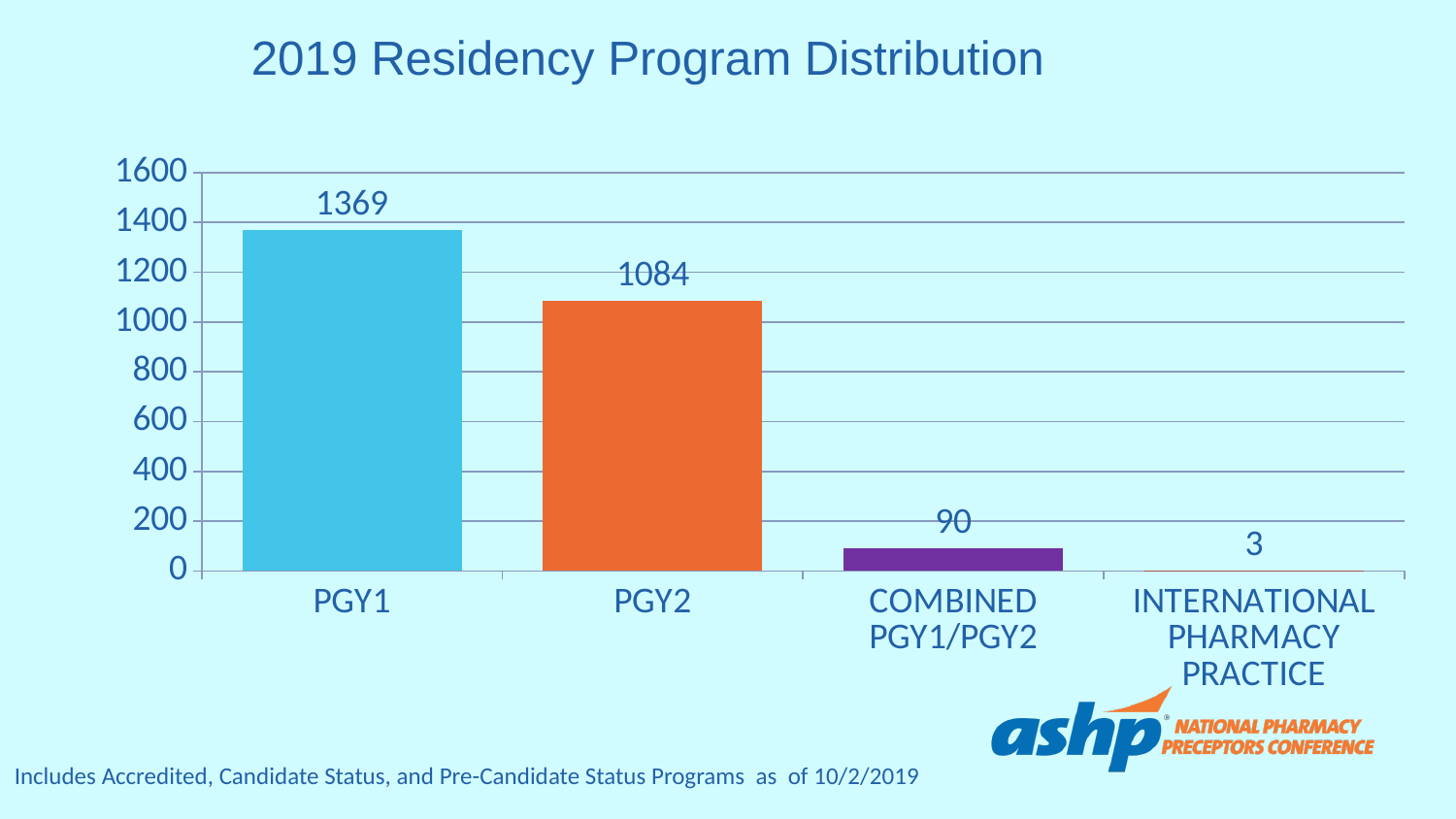
Is the value for PGY2 greater or less than 1000? greater What kind of chart is shown on the slide? bar chart What is the title of the chart? 2019 Residency Program Distribution What is the value for PGY1? 1369 How many categories are shown on the x axis? 4 What is the value for COMBINED PGY1/PGY2? 90 Which category has the highest value? PGY1 Which category has the lowest value? INTERNATIONAL PHARMACY PRACTICE What is the value for INTERNATIONAL PHARMACY PRACTICE? 3 What is the value for PGY2? 1084 What is the difference between the values for PGY1 and PGY2? 285 Which is larger, the value for PGY2 or the value for COMBINED PGY1/PGY2? PGY2